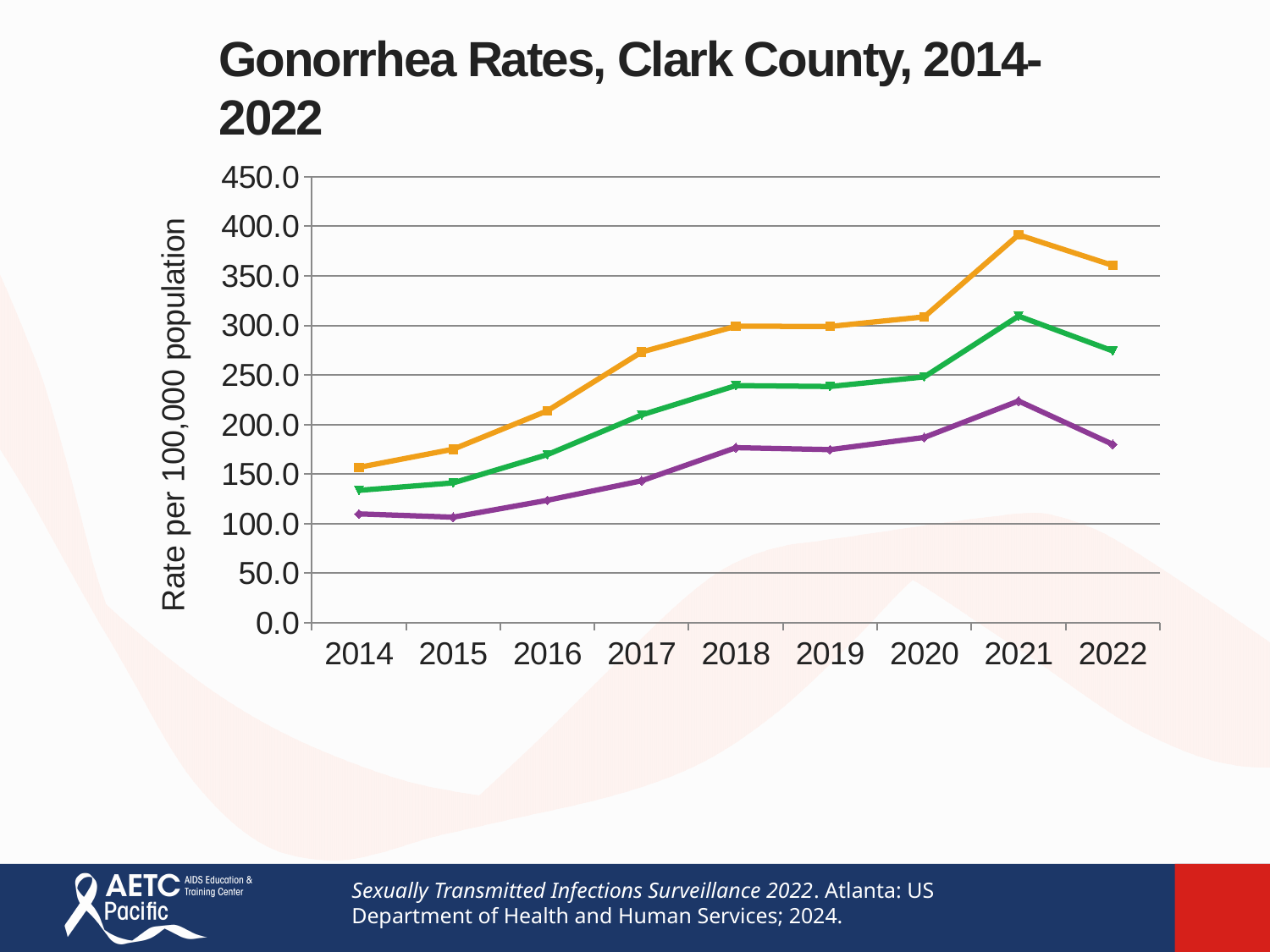
What is the label on the y axis of the chart? Rate per 100,000 population Is the value of the green line in 2014 greater or less than 150.0? less Is the value of the orange line in 2021 greater or less than 350.0? greater In which year does the orange line reach its highest value? 2021 Does the orange line generally rise or fall from 2014 to 2021? rise How many lines are plotted on the chart? 3 How many years are shown along the x axis of the chart? 9 In which year is the orange line at its lowest value? 2014 What is the title of the chart? Gonorrhea Rates, Clark County, 2014-2022 What kind of chart is shown on the slide? line chart In 2020, which line has the higher value, the orange line or the purple line? orange line Is the value of the purple line in 2021 greater or less than 200.0? greater